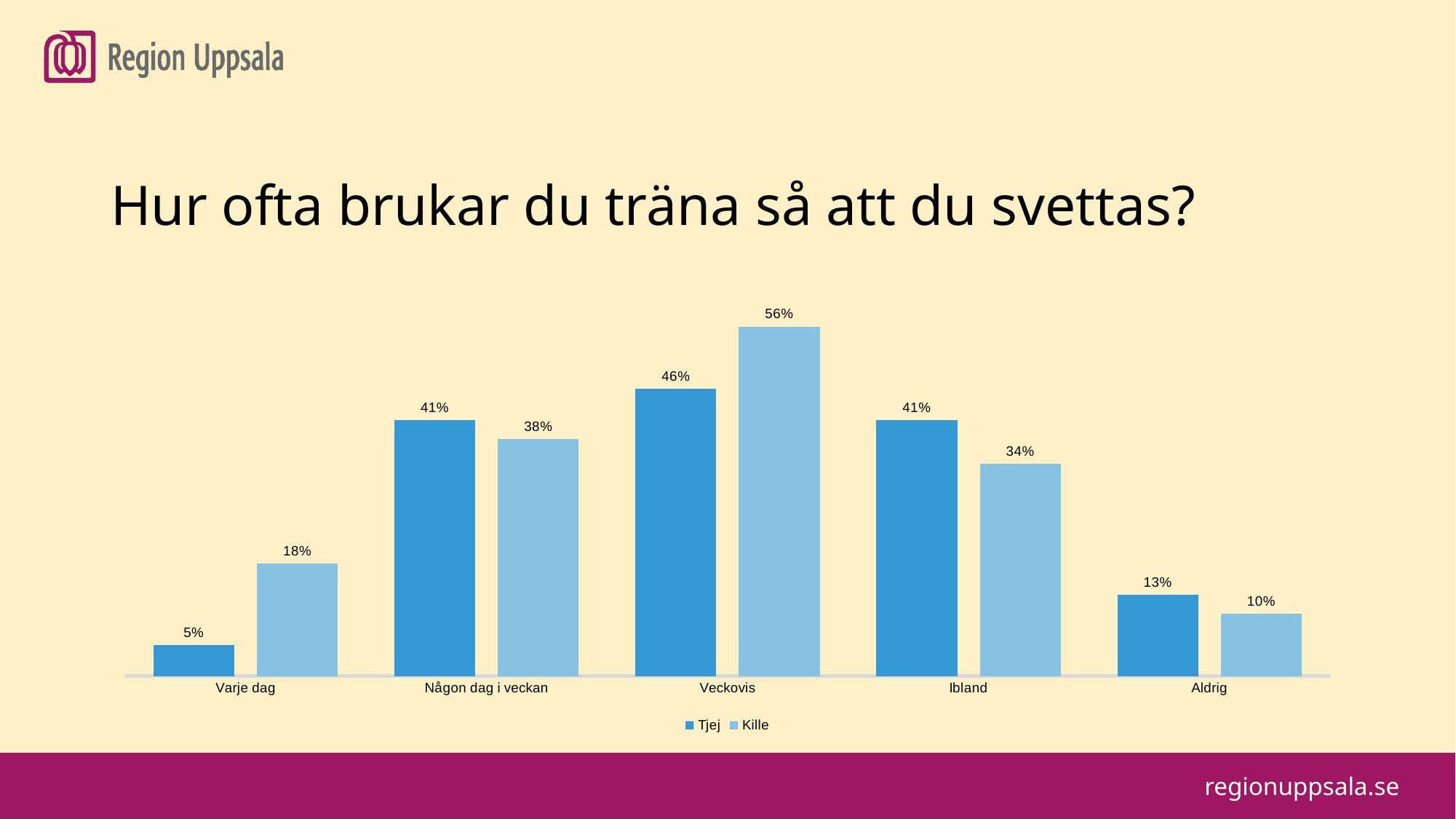
What are the two series named in the legend? Tjej and Kille What is the value for Tjej in the Varje dag category? 5% What is the difference between the Kille and Tjej values in the Varje dag category? 13% What is the difference between the Tjej and Kille values in the Ibland category? 7% What is the value for Kille in the Veckovis category? 56% What kind of chart is shown on the slide? Bar chart How many series does the legend list? 2 In the Någon dag i veckan category, which is larger, Tjej or Kille? Tjej How many categories are shown on the x axis? 5 Which category has the highest value for Kille? Veckovis Which category has the lowest value for Tjej? Varje dag What is the value for Kille in the Ibland category? 34%